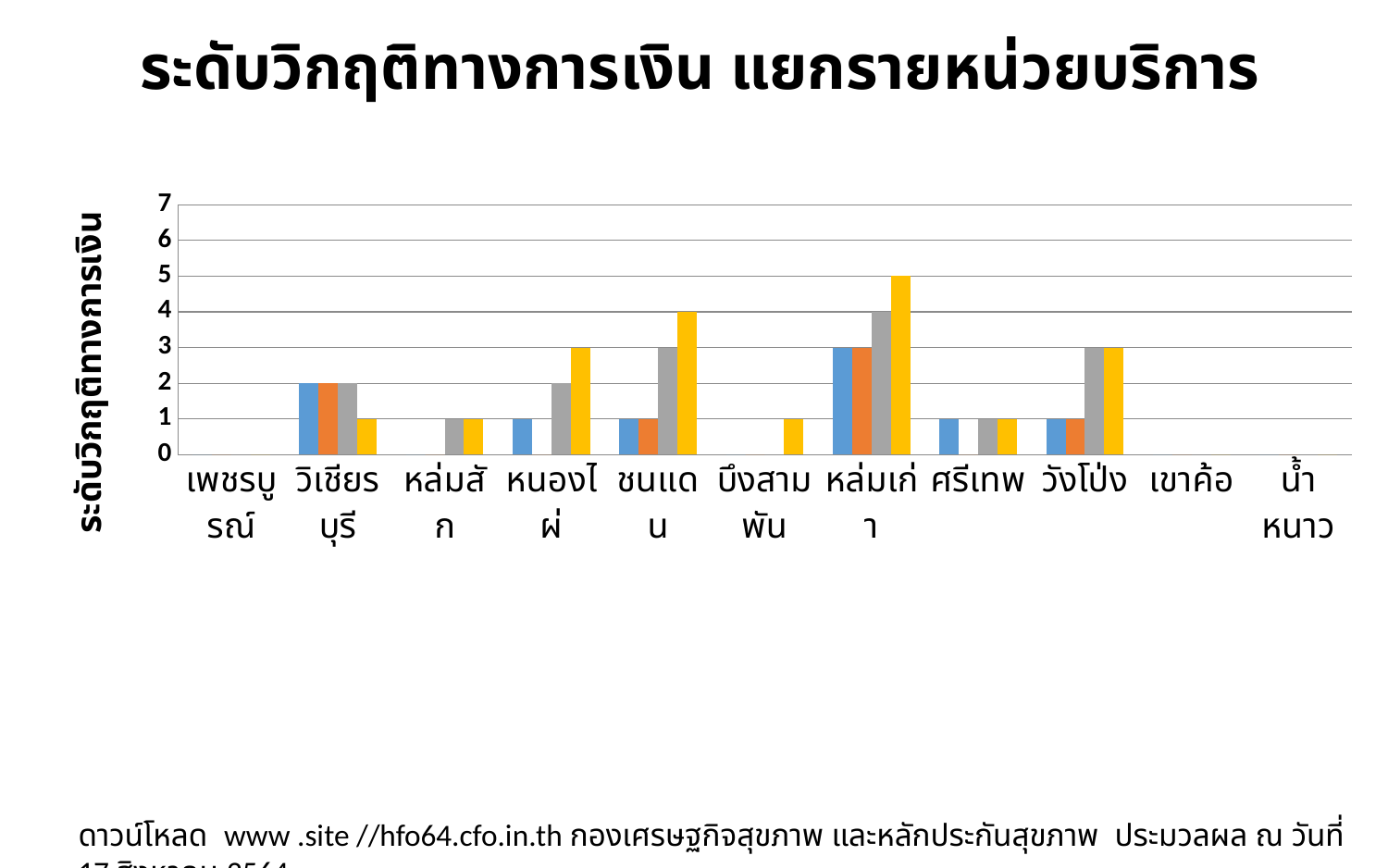
What is the value of the yellow bar for ชนแดน? 4 What is the value of the blue bar for วิเชียรบุรี? 2 What is the title of the chart? ระดับวิกฤติทางการเงิน แยกรายหน่วยบริการ Which service unit has the highest yellow bar? หล่มเก่า Is the yellow bar for หล่มเก่า greater or less than 4? greater What is the value of the gray bar for หนองไผ่? 2 Which is larger, the gray bar for หล่มเก่า or the gray bar for ชนแดน? หล่มเก่า What is the value of the yellow bar for หล่มเก่า? 5 What is the highest tick value shown on the y axis? 7 How many service units (categories) are shown on the x axis? 11 What type of chart is shown on the slide? bar chart What is the difference between the yellow bar for หล่มเก่า and the yellow bar for ชนแดน? 1